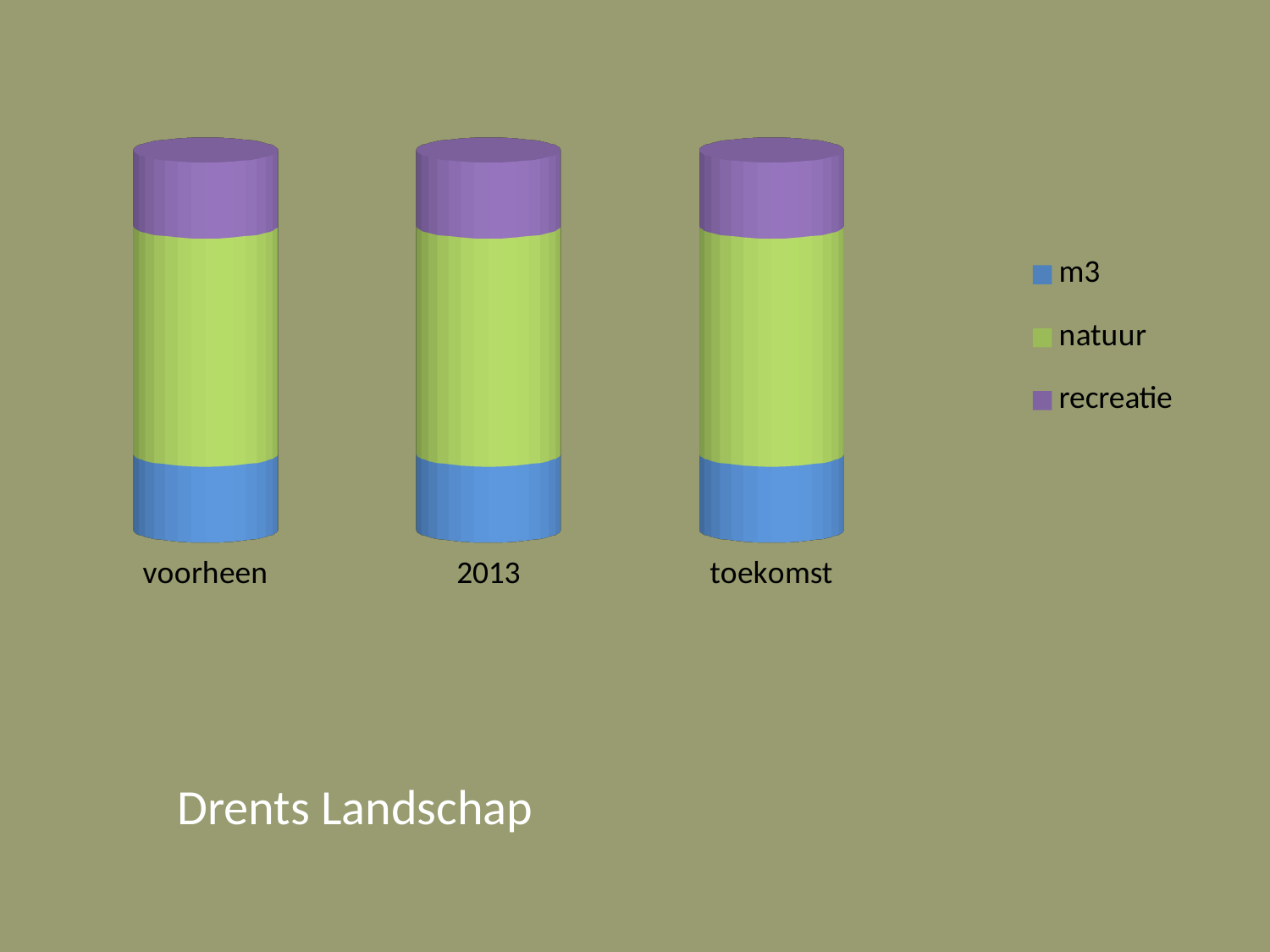
How many series does the chart's legend list? 3 Which series takes up the largest portion of the bar for 'voorheen'? natuur Which series is shown in green in the chart? natuur Which series is plotted at the bottom of each stacked bar? m3 What kind of chart is shown on the slide? stacked bar chart Which series takes up the largest portion of the bar for '2013'? natuur In the bar for 'voorheen', which segment is larger: recreatie or natuur? natuur In the bar for 'toekomst', which segment is larger: natuur or m3? natuur What are the three category labels on the x axis, from left to right? voorheen, 2013, toekomst How many categories are shown along the x axis of the chart? 3 Which series takes up the largest portion of the bar for 'toekomst'? natuur